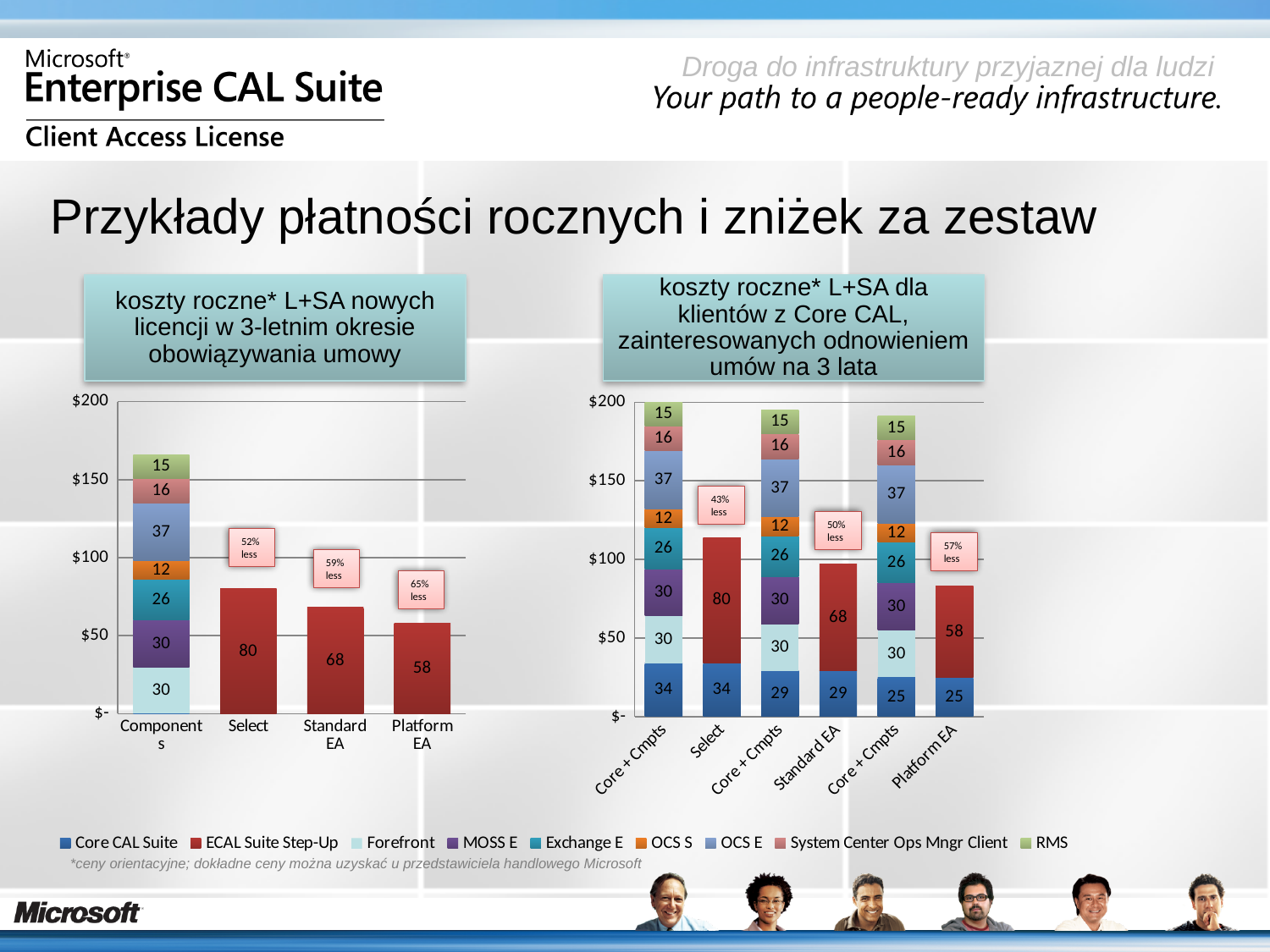
What kind of chart is the left chart? Stacked bar chart On the left chart, what is the total of the stacked bar for Components? 166 On the right chart, which is larger: the ECAL Suite Step-Up segment for Select or for Platform EA? Select On the right chart, what is the total of the stacked bar for Platform EA? 83 On the left chart, how many categories are shown on the x axis? 4 On the right chart, what is the value of the ECAL Suite Step-Up segment for Standard EA? 68 On the left chart, what is the value of the ECAL Suite Step-Up segment for Platform EA? 58 On the right chart, what is the value of the Core CAL Suite segment for Select? 34 On the left chart, what is the difference between the Select value (80) and the Standard EA value (68)? 12 On the right chart, is the total for Standard EA greater or less than $100? less How many series does the shared legend list? 9 On the left chart, what is the value of the ECAL Suite Step-Up segment for Select? 80